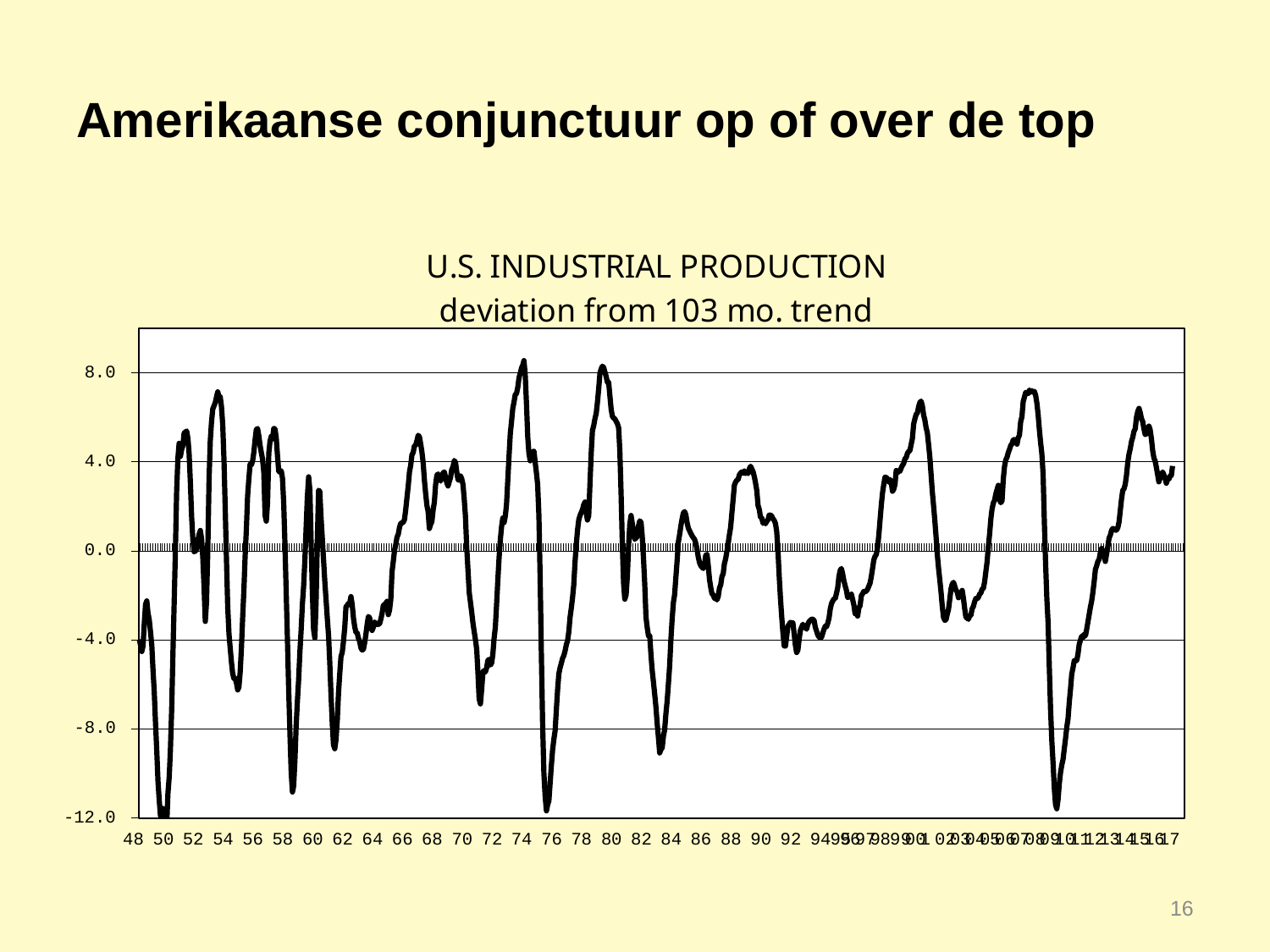
Does the line rise or fall between 2007 and 2009? fall What is the highest value shown on the vertical axis? 8.0 Is the value at the peak around 2000 greater or less than 4.0? greater Does the line rise or fall between 1975 and 1979? rise Is the value at the trough around 2009 greater or less than -8.0? less Is the value at the trough around 1982 greater or less than -4.0? less What kind of chart is shown on the slide? line chart What is the title of the chart? U.S. INDUSTRIAL PRODUCTION deviation from 103 mo. trend How many lines are plotted on the chart? 1